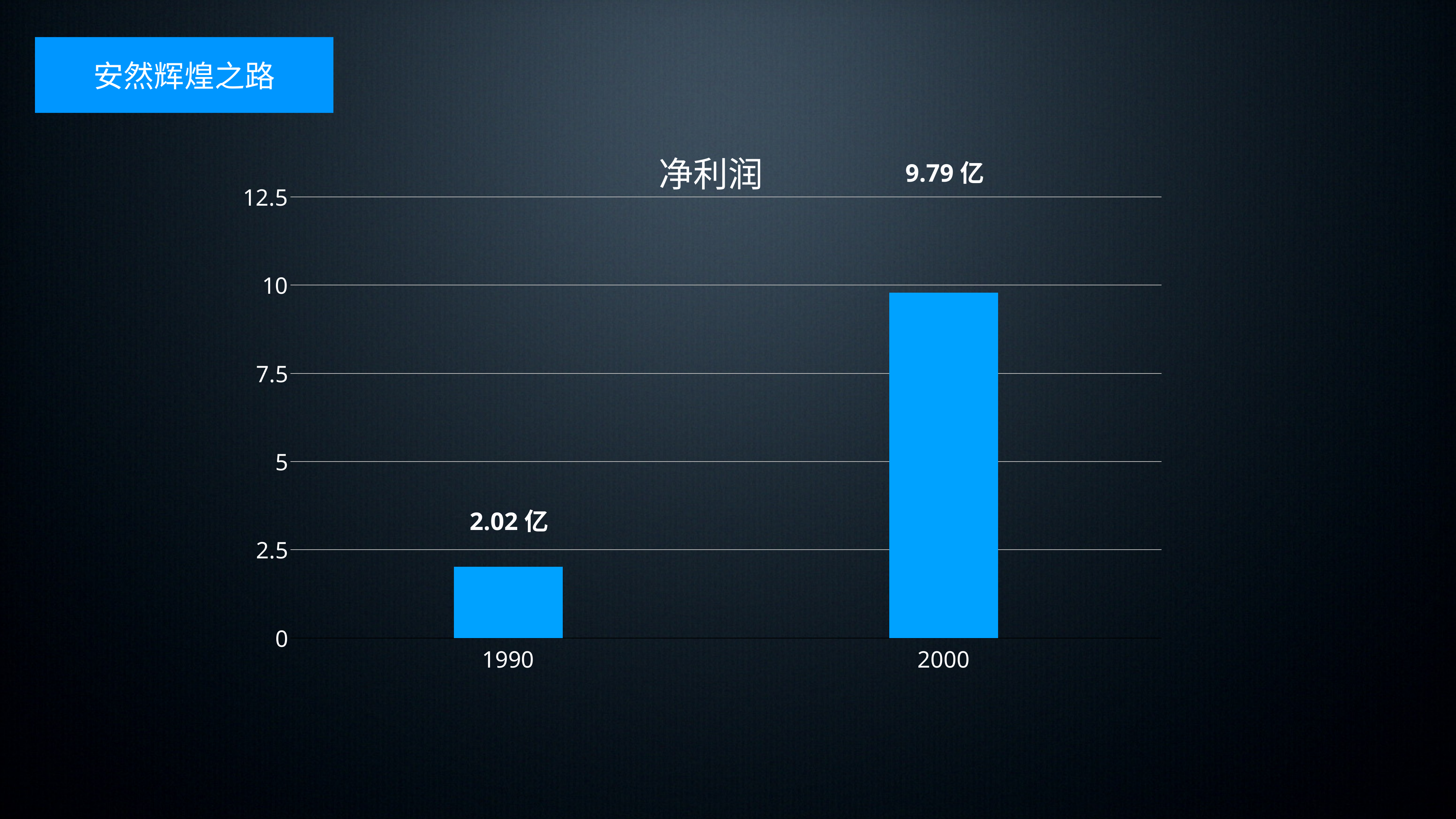
Is the net profit for 1990 greater or less than 2.5? less Which year has the higher net profit? 2000 What is the difference between the net profit in 2000 and in 1990? 7.77 亿 What is the title of the chart? 净利润 What is the highest value labelled on the vertical axis? 12.5 Is the net profit for 2000 greater or less than 7.5? greater What kind of chart is shown on the slide? Bar chart What is the net profit (净利润) value shown for 2000? 9.79 亿 Which year has the lower net profit? 1990 How many years (categories) are shown on the chart? 2 Does the net profit rise or fall from 1990 to 2000? Rise What is the net profit (净利润) value shown for 1990? 2.02 亿